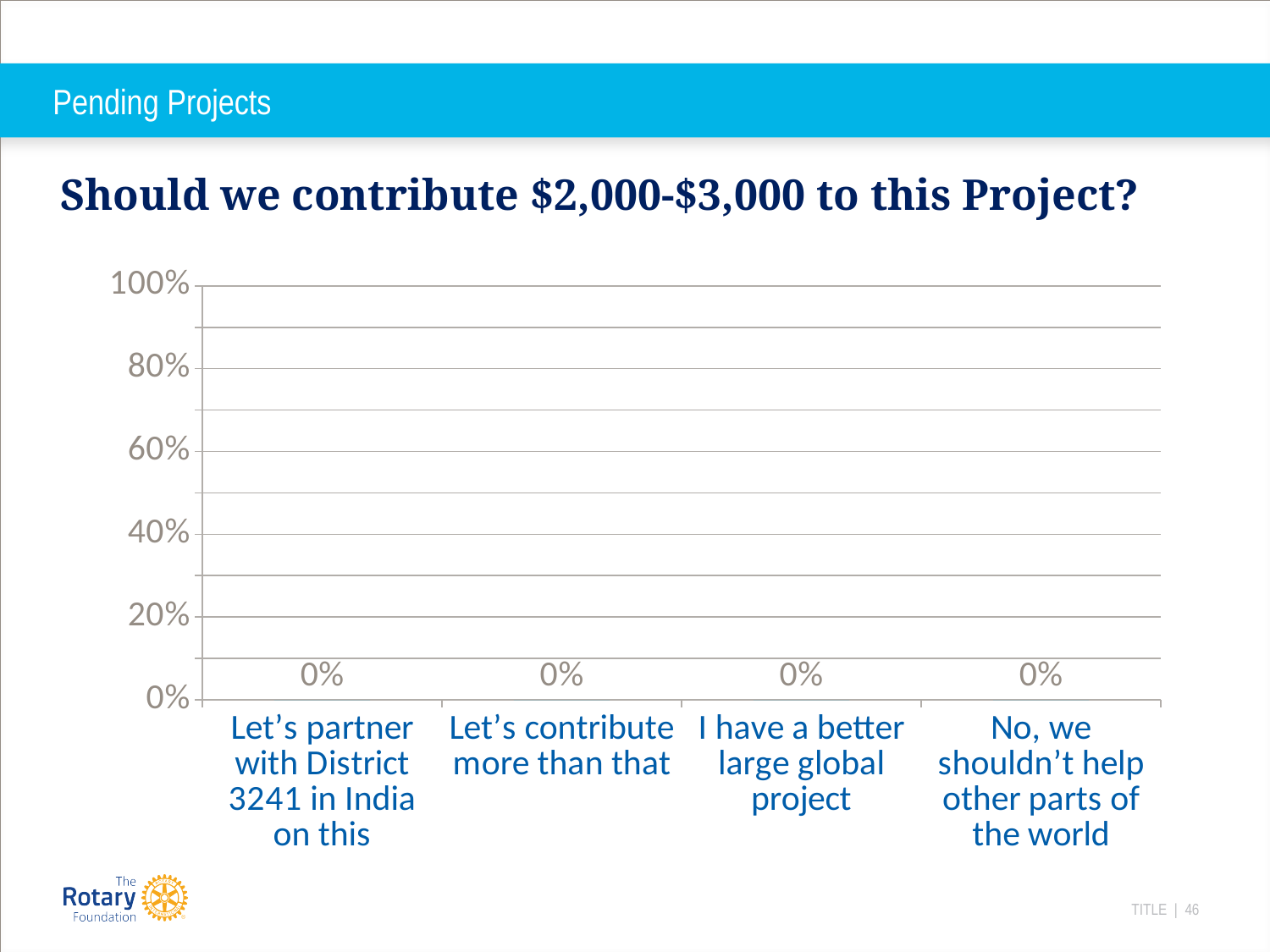
What is the value for "No, we shouldn't help other parts of the world"? 0% How many categories are shown on the x axis of the chart? 4 What is the value for "Let's contribute more than that"? 0% Do the values rise, fall, or stay flat across the categories on the x axis? stay flat What is the difference between the values for "Let's partner with District 3241 in India on this" and "No, we shouldn't help other parts of the world"? 0% What is the value for "I have a better large global project"? 0% What is the highest value labelled on the y axis of the chart? 100% What kind of chart is shown on the slide? bar chart Is the value for "Let's contribute more than that" greater or less than 20%? less What is the value for "Let's partner with District 3241 in India on this"? 0% What is the title of the chart? Should we contribute $2,000-$3,000 to this Project?